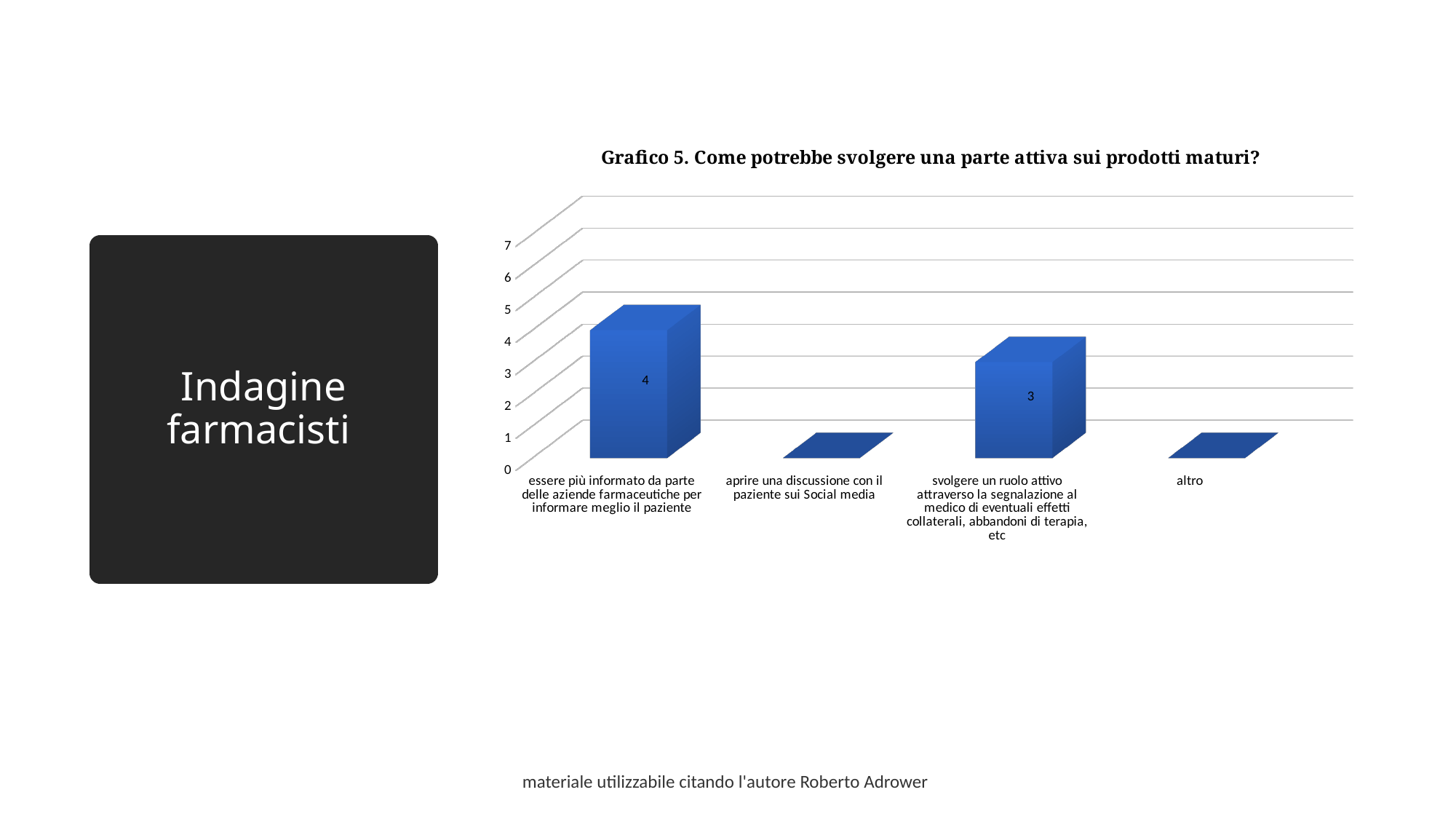
Which category has the highest value? essere più informato da parte delle aziende farmaceutiche per informare meglio il paziente Is the value for 'essere più informato da parte delle aziende farmaceutiche per informare meglio il paziente' greater or less than 2? greater What is the value for 'essere più informato da parte delle aziende farmaceutiche per informare meglio il paziente'? 4 Is the value for 'altro' greater or less than 1? less How many categories have a bar rising above zero? 2 Is the value for 'aprire una discussione con il paziente sui Social media' greater or less than 2? less What is the difference between the value for 'essere più informato da parte delle aziende farmaceutiche per informare meglio il paziente' and the value for 'svolgere un ruolo attivo attraverso la segnalazione al medico di eventuali effetti collaterali, abbandoni di terapia, etc'? 1 Which is larger: the value for 'aprire una discussione con il paziente sui Social media' or the value for 'svolgere un ruolo attivo attraverso la segnalazione al medico di eventuali effetti collaterali, abbandoni di terapia, etc'? svolgere un ruolo attivo attraverso la segnalazione al medico di eventuali effetti collaterali, abbandoni di terapia, etc How many categories are shown on the x axis of the chart? 4 What is the title of the chart? Grafico 5. Come potrebbe svolgere una parte attiva sui prodotti maturi? What is the value for 'svolgere un ruolo attivo attraverso la segnalazione al medico di eventuali effetti collaterali, abbandoni di terapia, etc'? 3 What kind of chart is shown on the slide? bar chart